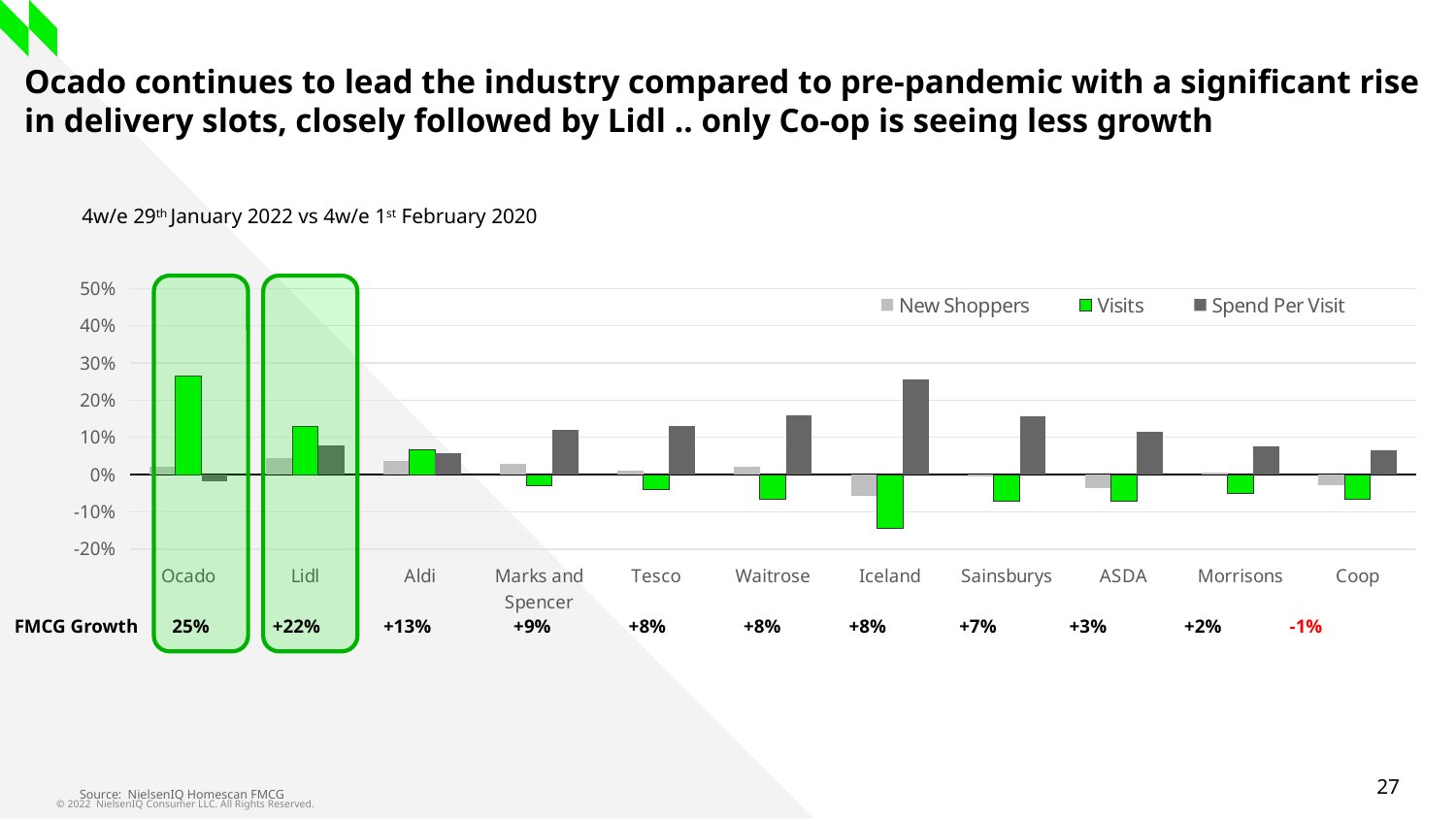
What is the FMCG Growth figure shown for Lidl? +22% Which two retailers are highlighted with green boxes on the chart? Ocado and Lidl How many retailers are shown along the x axis of the chart? 11 How many series does the chart legend list? 3 Is the Visits value for Iceland greater or less than -10%? less Is the Spend Per Visit value for Iceland greater or less than 20%? greater Which retailer has the highest Visits value? Ocado What is the FMCG Growth figure shown for Coop? -1% What kind of chart is shown on the slide? Bar chart Which retailer has the lowest Visits value? Iceland Is the Visits value for Ocado greater or less than 20%? greater Which retailer has the highest Spend Per Visit value? Iceland